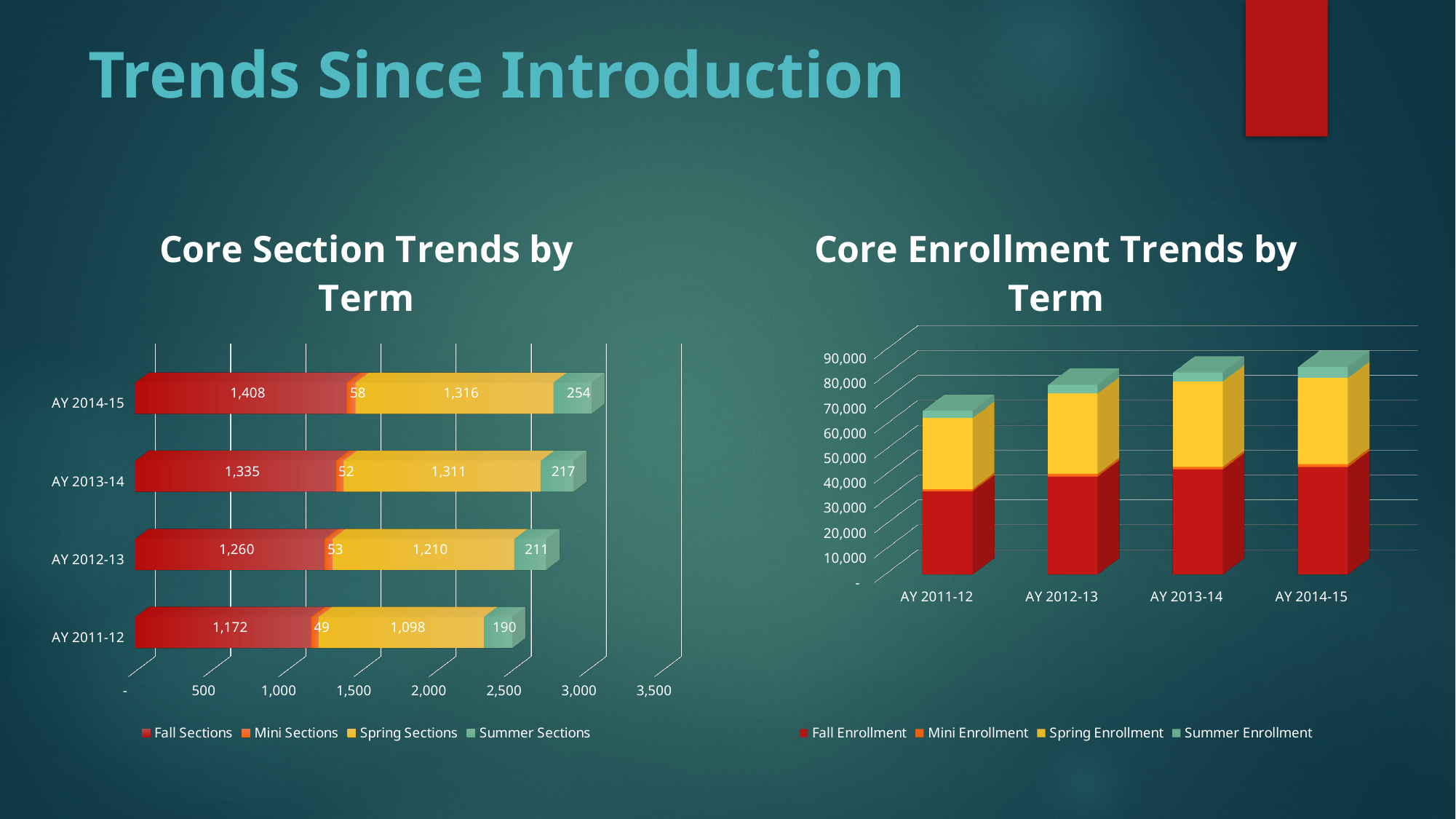
In the Core Section Trends by Term chart, what is the total number of sections across all four terms in AY 2012-13? 2,734 In the Core Section Trends by Term chart, what is the difference between Fall Sections in AY 2014-15 and AY 2011-12? 236 How many academic years are shown on the x axis of the Core Enrollment Trends by Term chart? 4 In the Core Section Trends by Term chart, how many Fall Sections were there in AY 2014-15? 1,408 In the Core Section Trends by Term chart, what is the value for Mini Sections in AY 2013-14? 52 How many series does the legend of the Core Enrollment Trends by Term chart list? 4 In the Core Section Trends by Term chart, which is larger: Spring Sections in AY 2013-14 or Spring Sections in AY 2012-13? Spring Sections in AY 2013-14 What kind of chart is the Core Enrollment Trends by Term chart? Stacked bar chart In the Core Section Trends by Term chart, which academic year has the highest number of Spring Sections? AY 2014-15 In the Core Enrollment Trends by Term chart, does total enrollment rise or fall from AY 2011-12 to AY 2014-15? Rise In the Core Section Trends by Term chart, which academic year has the lowest number of Fall Sections? AY 2011-12 In the Core Section Trends by Term chart, what is the value for Summer Sections in AY 2011-12? 190